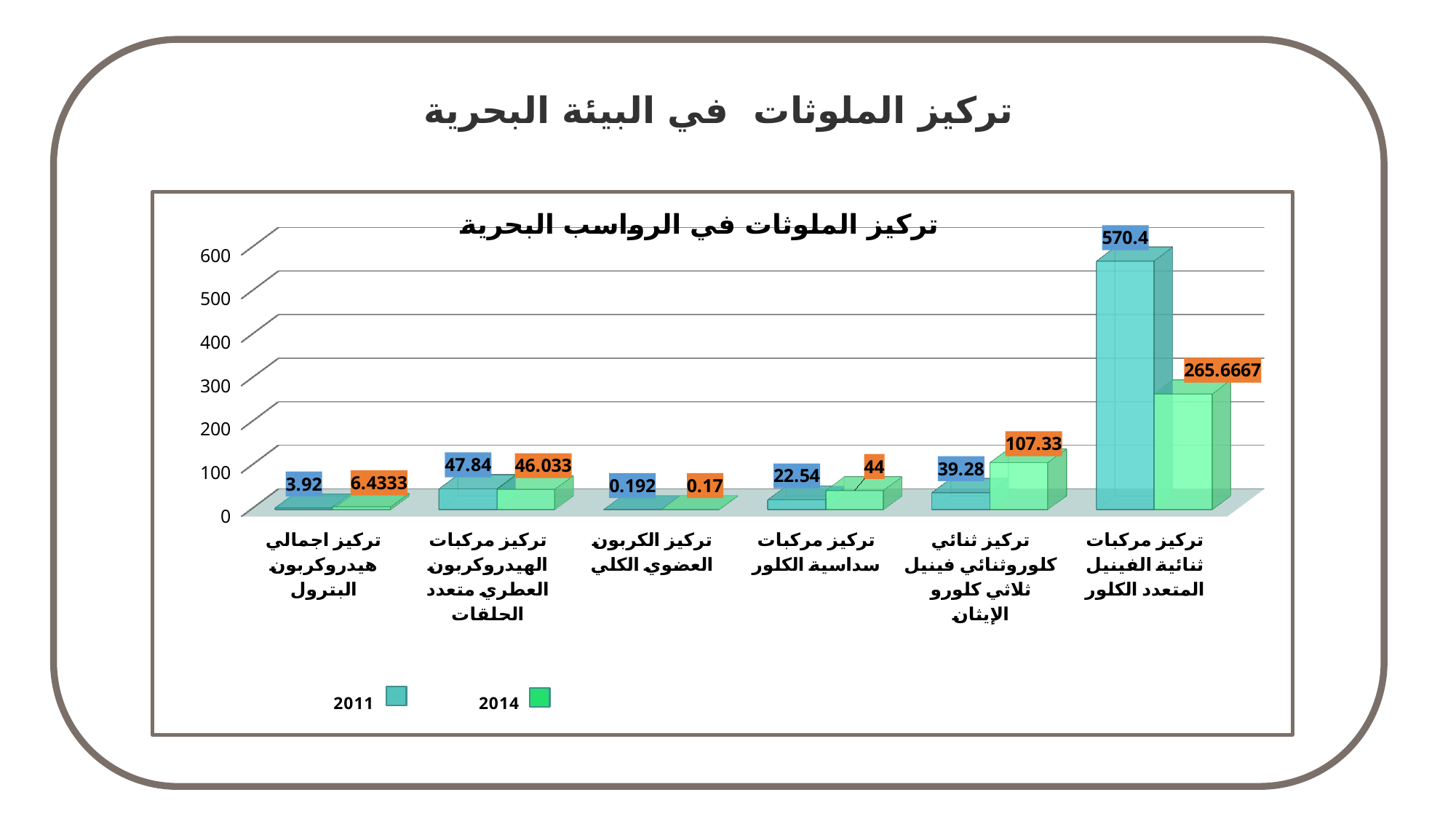
How many series does the legend list? 2 How many categories are shown on the x axis? 6 What is the 2011 value for تركيز الكربون العضوي الكلي? 0.192 For تركيز ثنائي كلوروثنائي فينيل ثلاثي كلورو الإيثان, which year has the larger value, 2011 or 2014? 2014 What kind of chart is shown on the slide? Bar chart What is the 2014 value for تركيز اجمالي هيدروكربون البترول? 6.4333 What is the 2011 value for تركيز مركبات ثنائية الفينيل المتعدد الكلور? 570.4 What is the difference between the 2011 and 2014 values for تركيز مركبات سداسية الكلور? 21.46 What is the 2014 value for تركيز ثنائي كلوروثنائي فينيل ثلاثي كلورو الإيثان? 107.33 Which category has the lowest 2011 value? تركيز الكربون العضوي الكلي What is the title of the chart? تركيز الملوثات في الرواسب البحرية Which category has the highest 2014 value? تركيز مركبات ثنائية الفينيل المتعدد الكلور